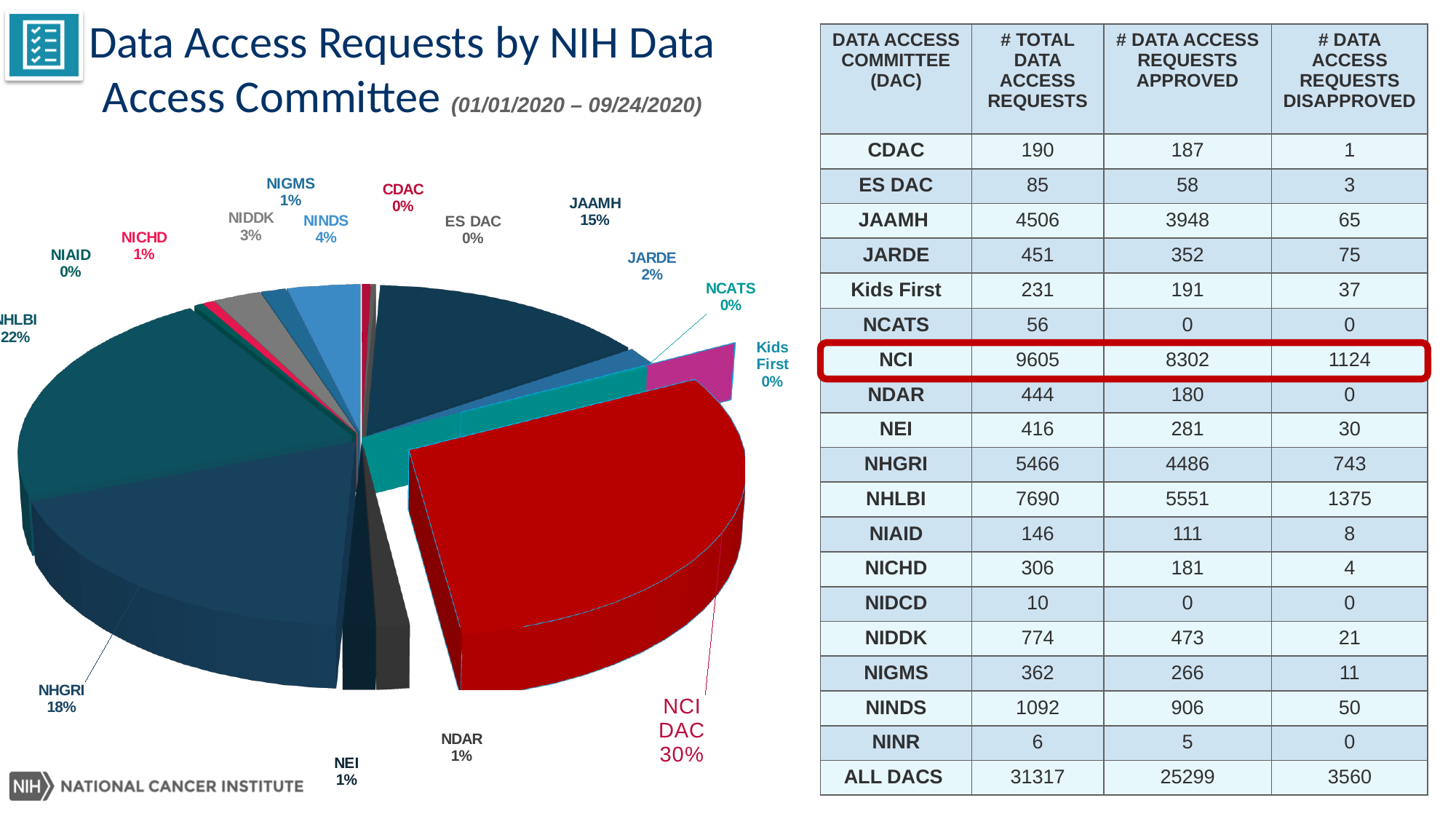
What percentage is shown for JAAMH in the pie chart? 15% What percentage is shown for NHLBI in the pie chart? 22% What percentage is shown for NIDDK in the pie chart? 3% What type of chart is shown on the left of the slide? pie chart In the pie chart, what is the difference in percentage points between the NCI DAC slice and the JAAMH slice? 15 In the pie chart, what is the difference in percentage points between the NHLBI slice and the NHGRI slice? 4 What percentage is shown for NHGRI in the pie chart? 18% Which DAC has the largest slice in the pie chart? NCI DAC In the pie chart, which is larger, the NHLBI slice or the NHGRI slice? NHLBI What share of data access requests does the NCI DAC slice represent in the pie chart? 30% What percentage is shown for NINDS in the pie chart? 4% What date range is given in the chart title? 01/01/2020 – 09/24/2020